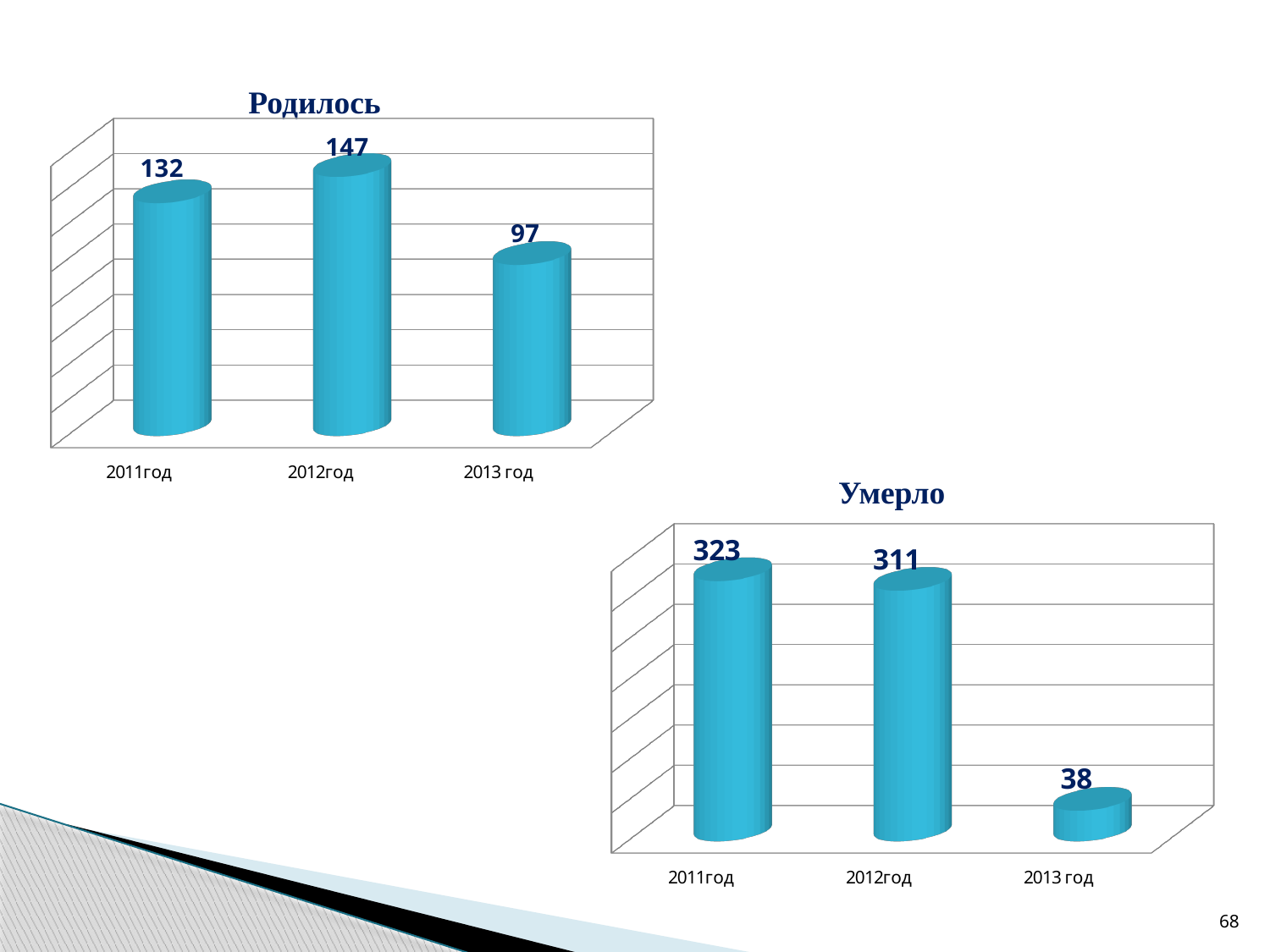
In the "Умерло" chart, what is the value for 2011год? 323 In the "Умерло" chart, which year has the lowest value? 2013 год In the "Родилось" chart, what is the value for 2013 год? 97 In the "Родилось" chart, which year has the highest value? 2012год How many categories are shown in the "Родилось" chart? 3 In the "Умерло" chart, what is the value for 2013 год? 38 In the "Родилось" chart, what is the value for 2012год? 147 In the "Умерло" chart, which is larger, the value for 2012год or the value for 2013 год? 2012год In the "Родилось" chart, what is the difference between the values for 2012год and 2011год? 15 In the "Умерло" chart, do the values rise or fall from 2011год to 2013 год? fall In the "Умерло" chart, what is the difference between the values for 2011год and 2012год? 12 What kind of chart is the "Умерло" chart? bar chart